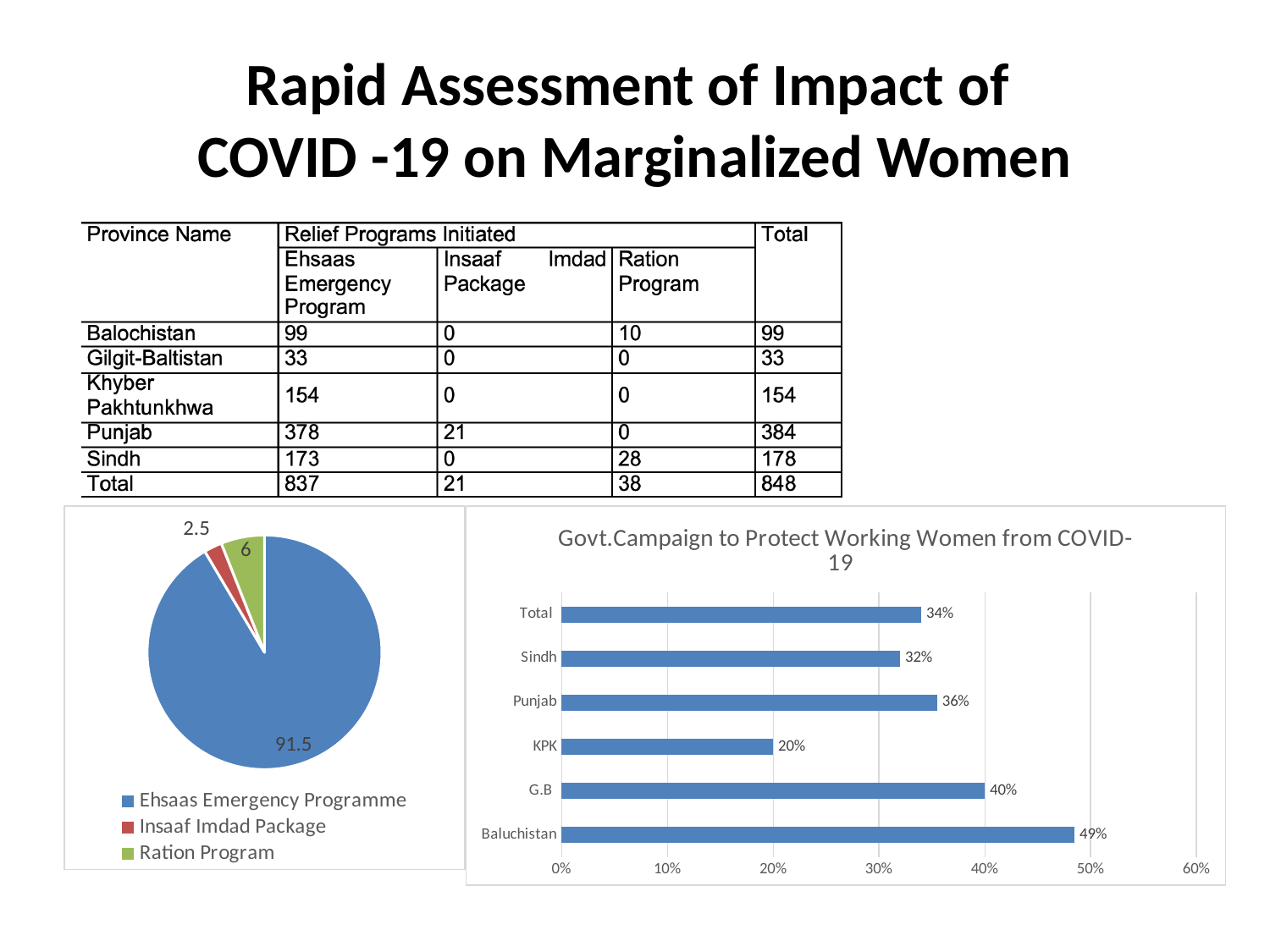
In the pie chart on the lower left of the slide, which slice is the smallest? Insaaf Imdad Package In the bar chart titled 'Govt.Campaign to Protect Working Women from COVID-19', what is the value for KPK? 20% In the pie chart on the lower left of the slide, what is the value for Ration Program? 6 In the bar chart titled 'Govt.Campaign to Protect Working Women from COVID-19', what is the difference between the values for G.B and Sindh? 8% In the bar chart titled 'Govt.Campaign to Protect Working Women from COVID-19', which category has the highest value? Baluchistan In the pie chart on the lower left of the slide, what is the value for Ehsaas Emergency Programme? 91.5 In the bar chart titled 'Govt.Campaign to Protect Working Women from COVID-19', which is larger, the value for Punjab or the value for Total? Punjab In the bar chart titled 'Govt.Campaign to Protect Working Women from COVID-19', which category has the lowest value? KPK What kind of chart is the chart titled 'Govt.Campaign to Protect Working Women from COVID-19'? Bar chart How many categories are shown in the bar chart titled 'Govt.Campaign to Protect Working Women from COVID-19'? 6 How many entries does the legend of the pie chart on the lower left of the slide list? 3 In the bar chart titled 'Govt.Campaign to Protect Working Women from COVID-19', what is the value for Baluchistan? 49%